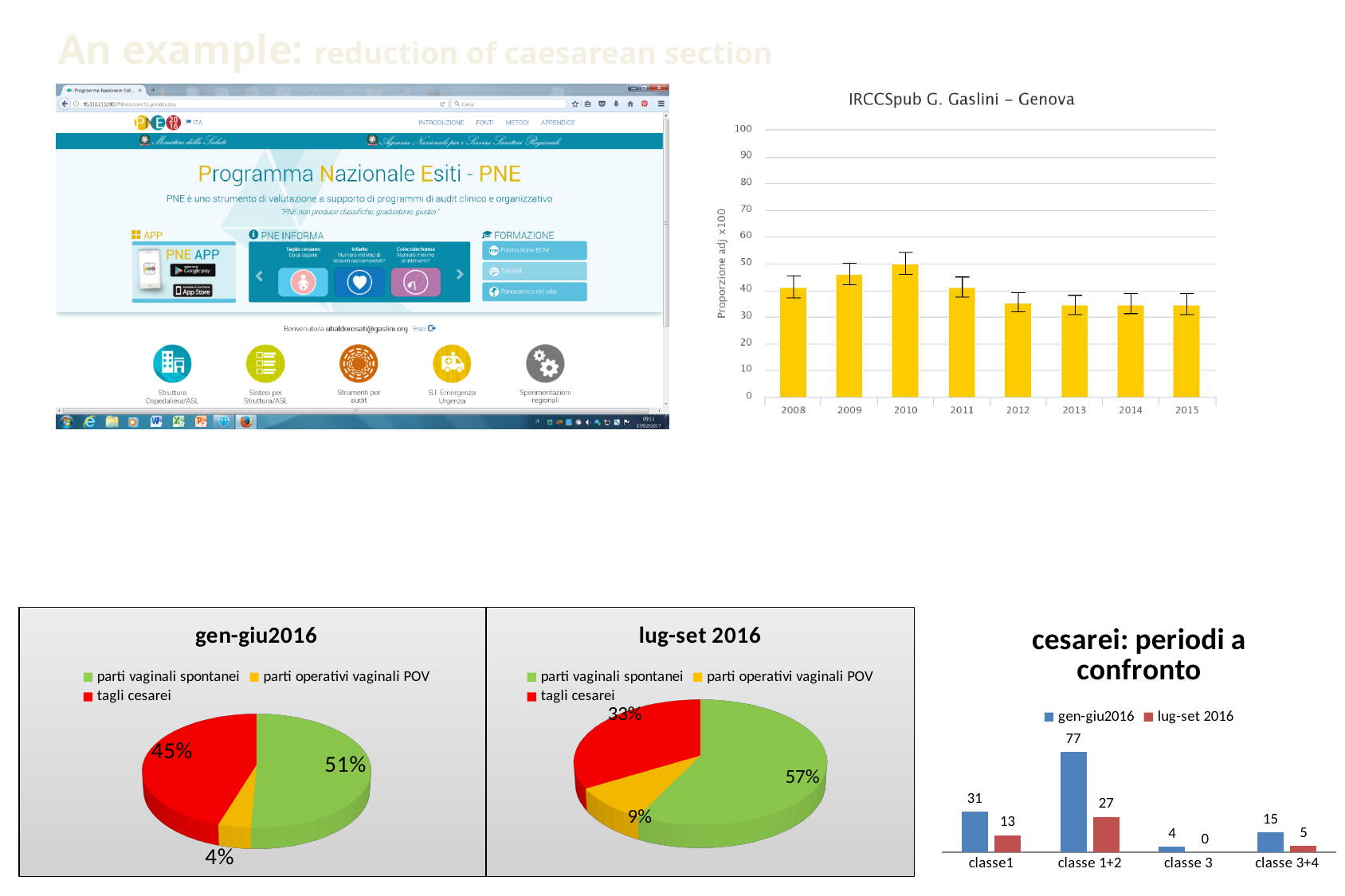
In the 'lug-set 2016' pie chart, which slice is the largest? parti vaginali spontanei In the 'IRCCSpub G. Gaslini – Genova' chart, how many years are shown on the x axis? 8 In the 'cesarei: periodi a confronto' chart, what is the value for classe 1+2 in gen-giu2016? 77 How many series does the legend of the 'cesarei: periodi a confronto' chart list? 2 In the 'lug-set 2016' pie chart, what share is parti operativi vaginali POV? 9% In the 'cesarei: periodi a confronto' chart, what is the value for classe 3 in lug-set 2016? 0 In the 'cesarei: periodi a confronto' chart, which category has the highest gen-giu2016 value? classe 1+2 In the 'gen-giu2016' pie chart, what share is tagli cesarei? 45% Is the share of tagli cesarei larger in the 'gen-giu2016' pie chart or in the 'lug-set 2016' pie chart? gen-giu2016 What kind of chart is 'IRCCSpub G. Gaslini – Genova'? bar chart In the 'cesarei: periodi a confronto' chart, what is the difference between the gen-giu2016 and lug-set 2016 values for classe1? 18 In the 'IRCCSpub G. Gaslini – Genova' chart, is the value for 2013 greater or less than 40? less